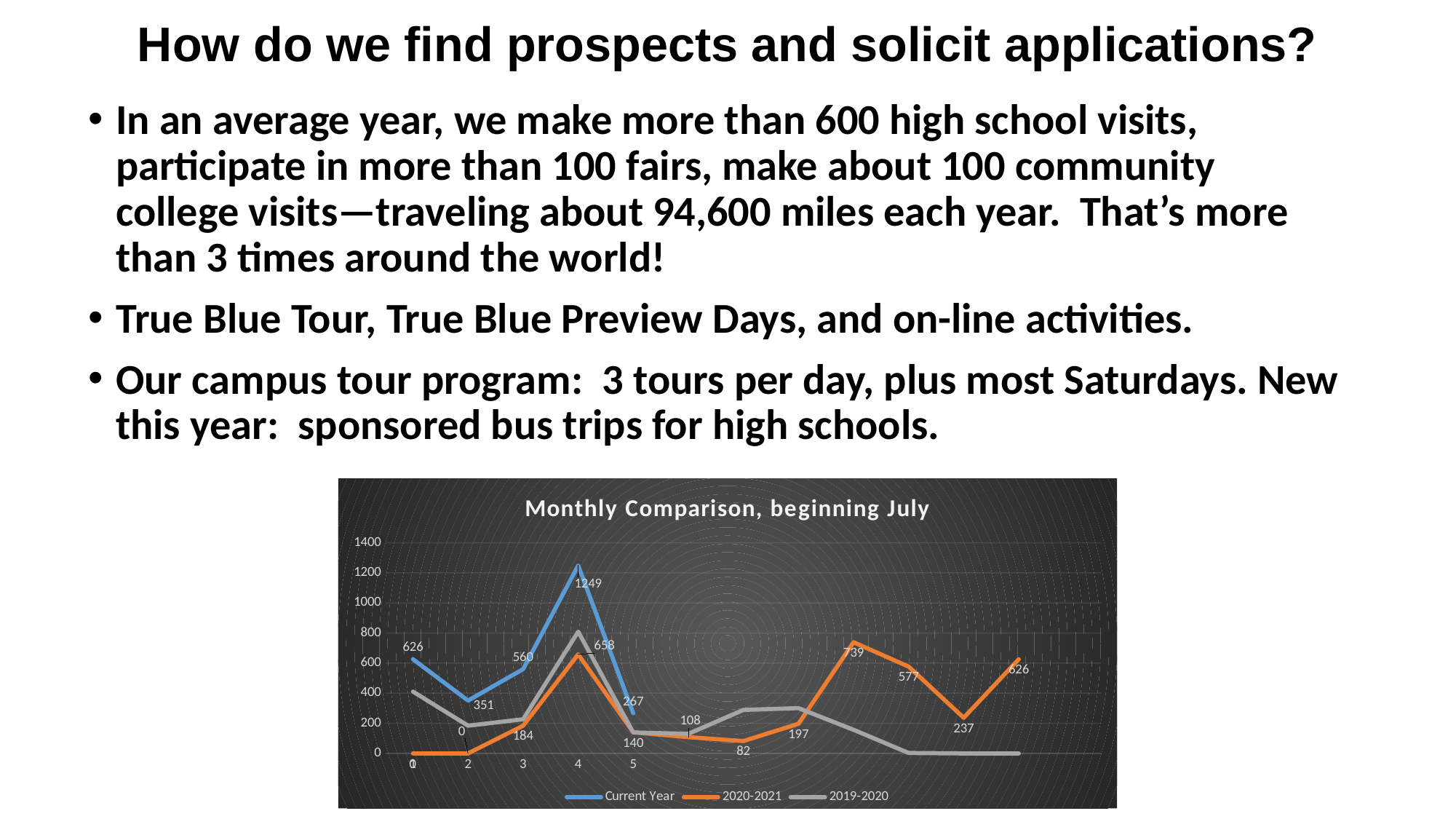
What is the value of the Current Year series at x = 3? 560 What is the highest value shown for the 2020-2021 series? 739 What is the value of the 2020-2021 series at x = 3? 184 Is the value of the 2019-2020 series at x = 4 greater or less than 600? greater At x = 5, which series has the larger value, Current Year or 2020-2021? Current Year What is the value of the 2020-2021 series at x = 4? 658 What is the difference between the Current Year value and the 2020-2021 value at x = 4? 591 What is the title of the chart on the slide? Monthly Comparison, beginning July What is the value of the Current Year series at x = 2? 351 How many series does the legend of the 'Monthly Comparison, beginning July' chart list? 3 What kind of chart is shown on the slide? line chart What is the highest value shown for the Current Year series? 1249